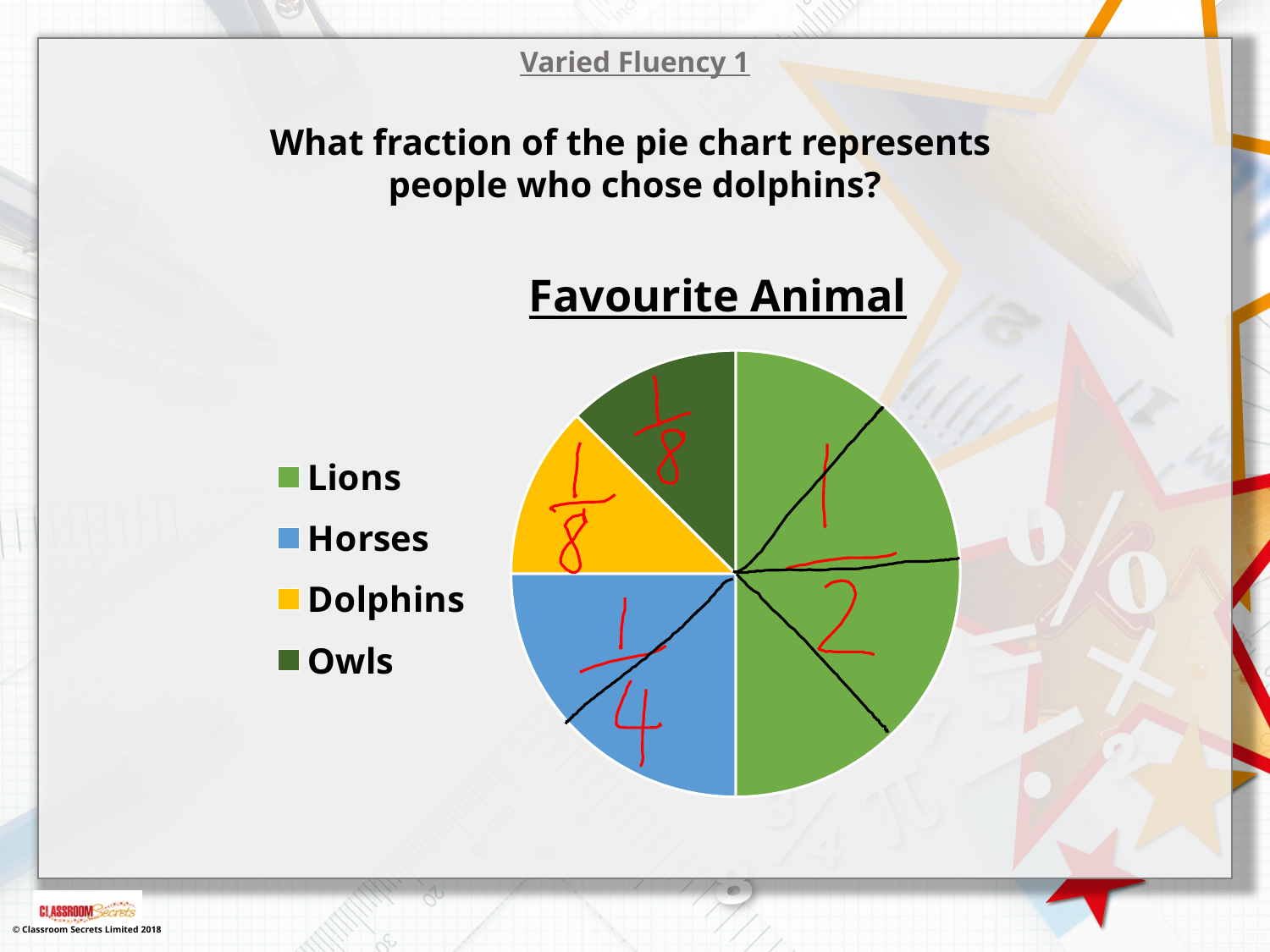
Which slice is larger, Lions or Horses? Lions What kind of chart is shown on the slide? pie chart What fraction of the pie chart represents people who chose horses? 1/4 How many entries does the legend list? 4 Which slice is larger, Horses or Dolphins? Horses What is the title of the pie chart? Favourite Animal What fraction of the pie chart represents people who chose dolphins? 1/8 Which animal has the largest slice of the pie chart? Lions What fraction of the pie chart represents people who chose lions? 1/2 How many categories does the pie chart have? 4 Which colour represents Dolphins in the pie chart? yellow